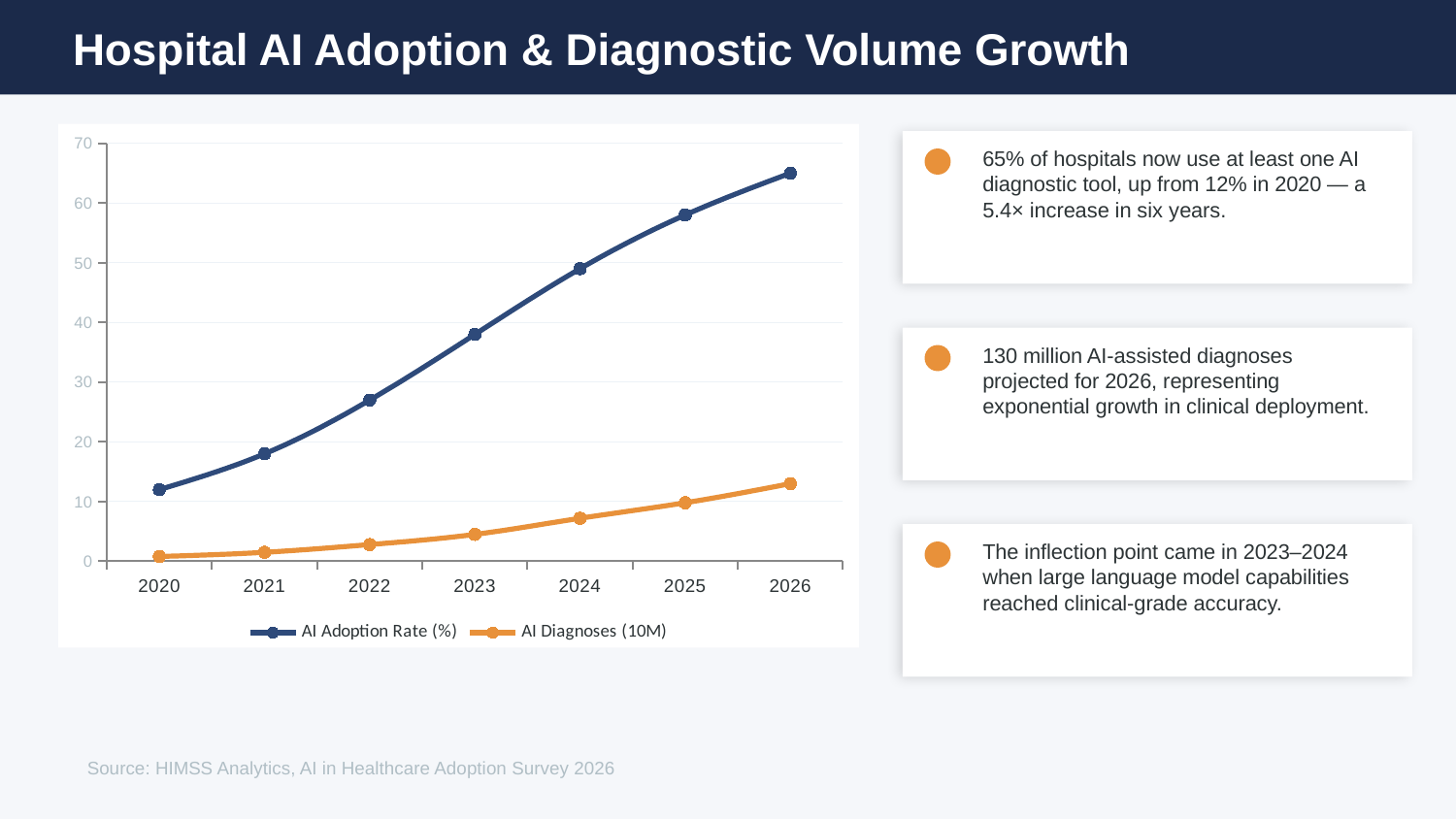
What kind of chart is shown on the slide? line chart Does the AI Diagnoses (10M) series rise or fall from 2020 to 2026? rise Is the AI Diagnoses (10M) value for 2026 greater or less than 10? greater What colour is the line for the AI Diagnoses (10M) series? orange How many years are plotted along the x axis of the chart? 7 Which is larger in 2024: the AI Adoption Rate (%) value or the AI Diagnoses (10M) value? AI Adoption Rate (%) How many series does the chart legend list? 2 In which year is the AI Diagnoses (10M) value lowest? 2020 Does the AI Adoption Rate (%) series rise or fall from 2020 to 2026? rise In which year is the AI Adoption Rate (%) highest? 2026 Is the AI Adoption Rate (%) value for 2022 greater or less than 30? less Is the AI Adoption Rate (%) value for 2026 greater or less than 60? greater